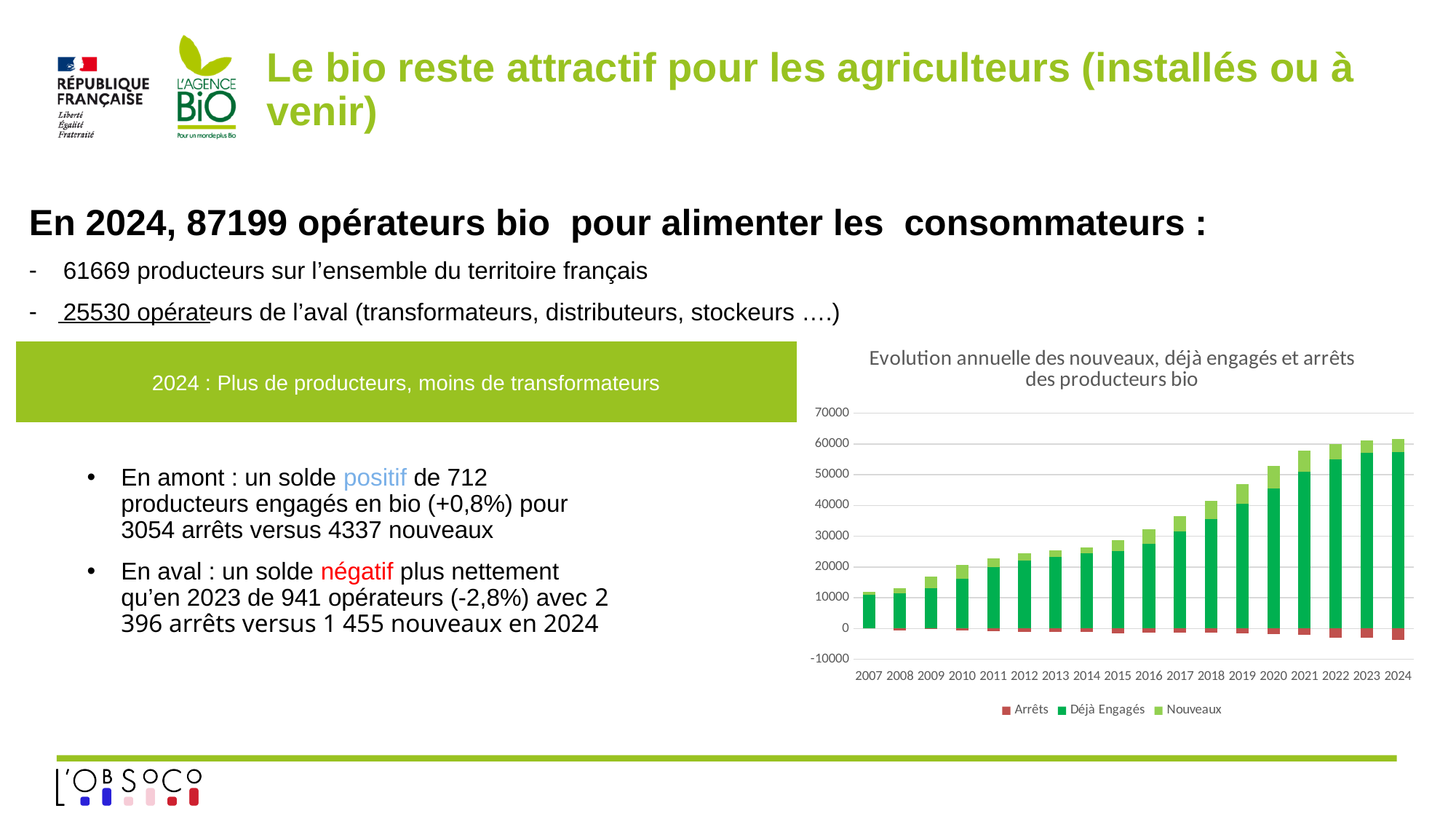
Is the Déjà Engagés value for 2018 greater or less than 30000? greater Which year has the larger Déjà Engagés value, 2015 or 2020? 2020 What is the title of the chart? Evolution annuelle des nouveaux, déjà engagés et arrêts des producteurs bio Is the Déjà Engagés value for 2007 greater or less than 20000? less How many series does the chart legend list? 3 How many years are shown on the x axis of the chart? 18 Is the Déjà Engagés value for 2024 greater or less than 50000? greater Which series in the chart is shown in red? Arrêts Does the Déjà Engagés series rise or fall from 2007 to 2024? rise Which year has the lowest value for Déjà Engagés? 2007 What kind of chart is shown on the slide? stacked bar chart